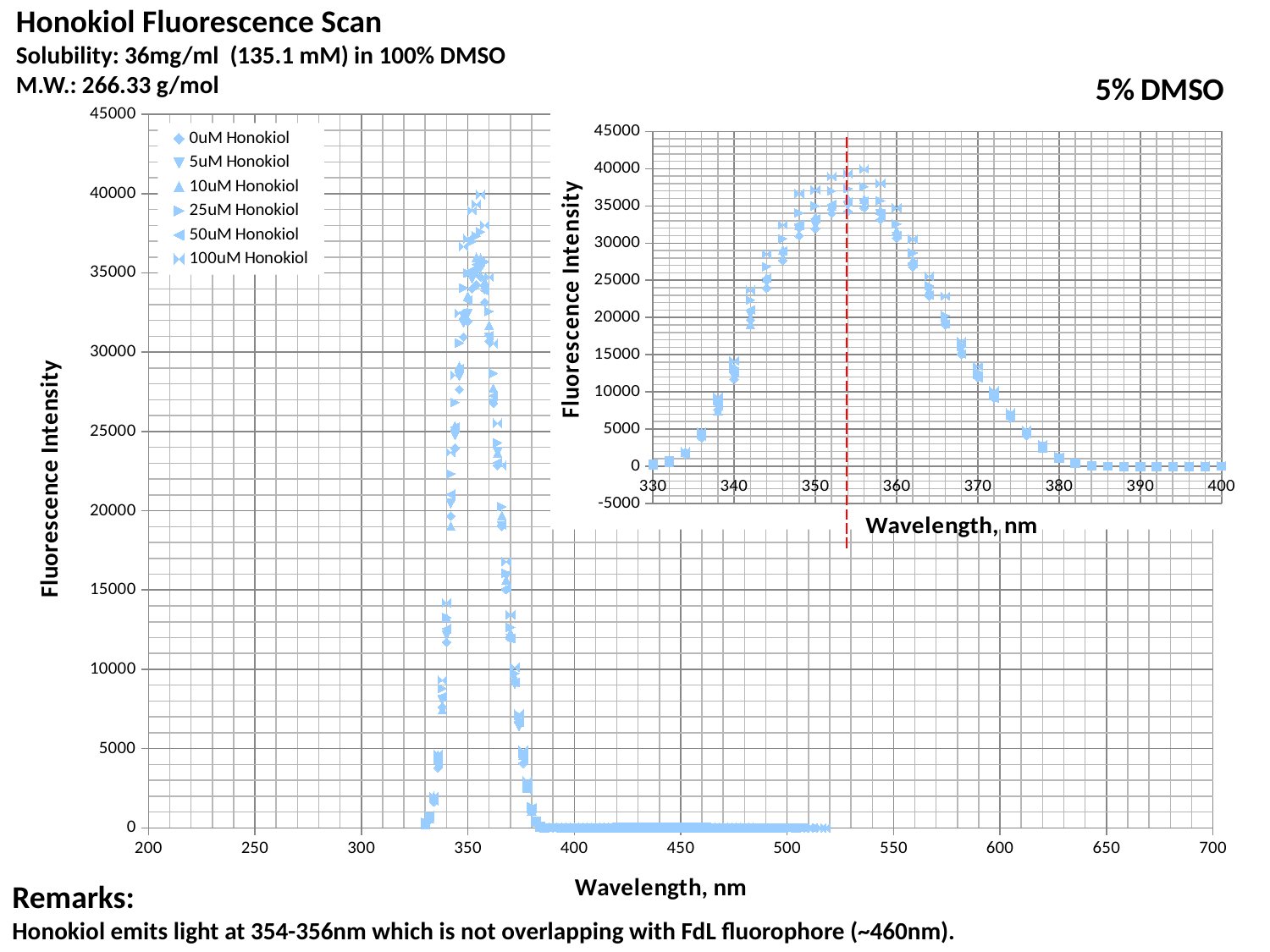
In the main chart, is the highest fluorescence intensity value greater or less than 35000? greater In the main chart, is the fluorescence intensity at 450 nm greater or less than 5000? less What kind of chart is the main chart on the left? scatter chart How many charts are shown on the slide? 2 In the inset chart (5% DMSO), do the fluorescence intensity values rise or fall between 330 nm and 350 nm? rise In the inset chart (5% DMSO), do the fluorescence intensity values rise or fall between 360 nm and 380 nm? fall How many series does the legend of the main chart list? 6 In the inset chart (5% DMSO), is the fluorescence intensity at 390 nm greater or less than 5000? less What is the x-axis title of the main chart? Wavelength, nm